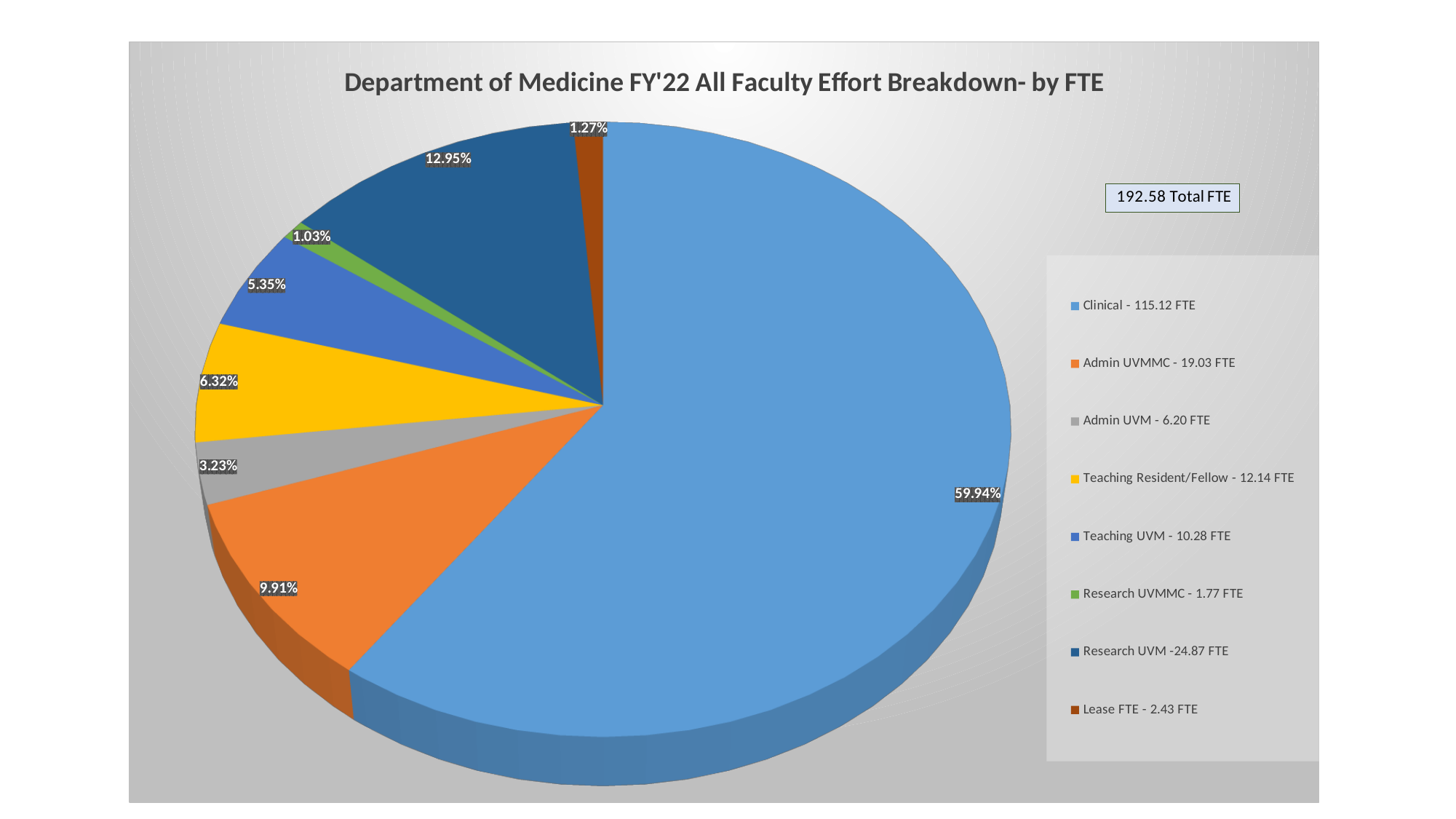
What percentage share is labeled for the Research UVM slice? 12.95% How many slices does the pie chart have? 8 What percentage share of the pie is labeled for the Clinical slice? 59.94% Which category has the smallest slice of the pie? Research UVMMC Which slice is larger, Teaching UVM or Admin UVM? Teaching UVM What type of chart is shown on the slide? Pie chart Which category has the largest slice of the pie? Clinical What is the title of the chart? Department of Medicine FY'22 All Faculty Effort Breakdown- by FTE According to the legend, how many FTE does Teaching Resident/Fellow account for? 12.14 FTE According to the legend, how many FTE does Admin UVMMC account for? 19.03 FTE What is the difference in percentage points between the Admin UVMMC slice (9.91%) and the Teaching Resident/Fellow slice (6.32%)? 3.59% What total FTE is stated on the slide? 192.58 Total FTE